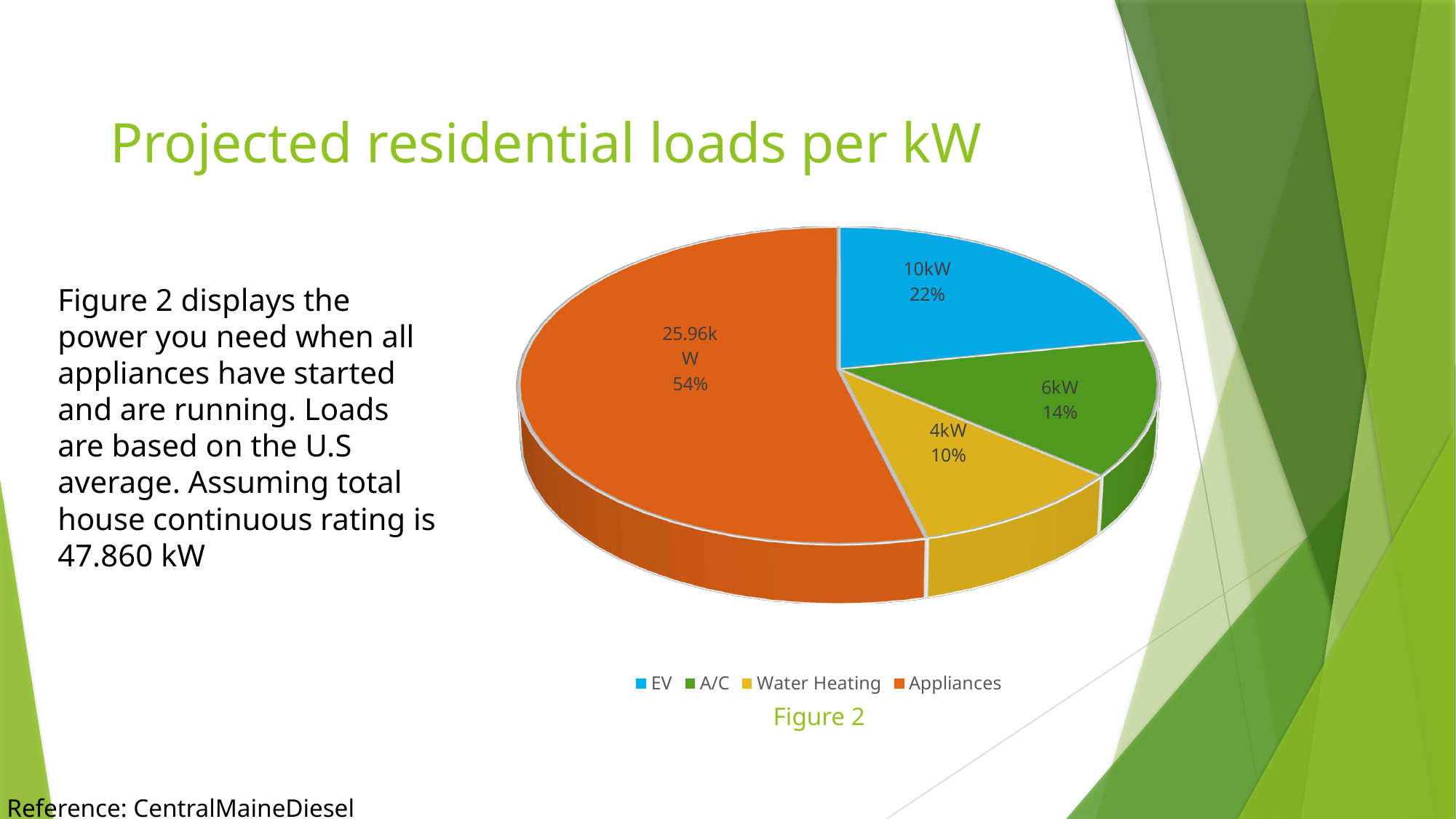
What is the load value for Appliances in the pie chart? 25.96kW What type of chart is shown on the slide? pie chart What is the difference in load between EV and A/C? 4kW What is the load value for EV in the pie chart? 10kW What is the load value for A/C in the pie chart? 6kW What share of the pie does Appliances represent? 54% How many categories does the legend of the pie chart list? 4 Which has a larger load, A/C or Water Heating? A/C What is the load value for Water Heating in the pie chart? 4kW What share of the pie does EV represent? 22% Which category has the smallest slice in the pie chart? Water Heating Which category has the largest slice in the pie chart? Appliances